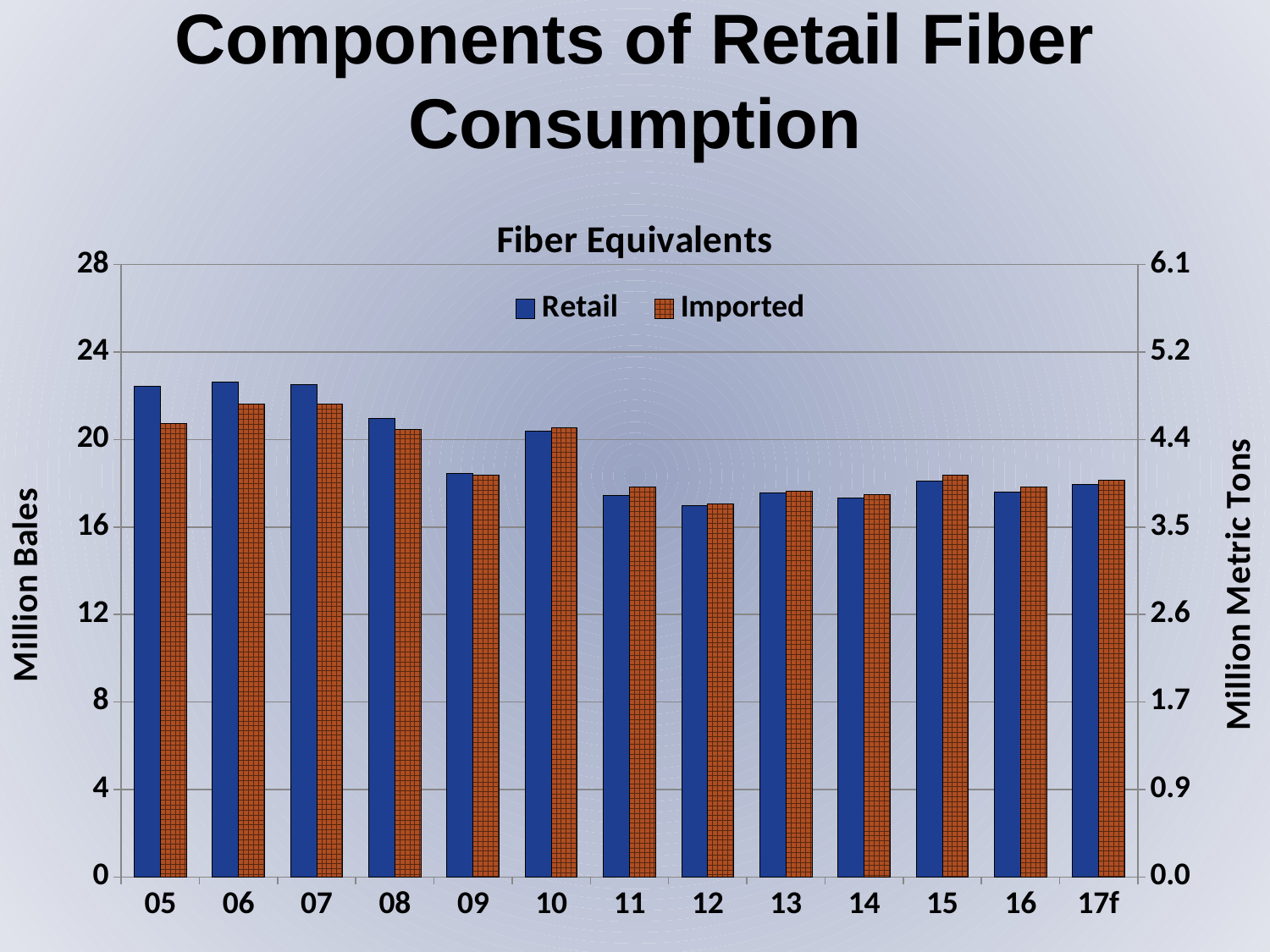
Is the Retail value for 05 greater or less than 20 million bales? greater Which year has the lowest Retail value? 12 How many series does the legend list? 2 Is the Retail value for 12 greater or less than 20 million bales? less In 11, which is larger, Retail or Imported? Imported What kind of chart is shown on the slide? bar chart How many year categories are shown on the x axis? 13 Is the Imported value for 06 greater or less than 20 million bales? greater In 05, which is larger, Retail or Imported? Retail What is the label on the left vertical axis? Million Bales Do the Retail values generally rise or fall from 05 to 12? fall